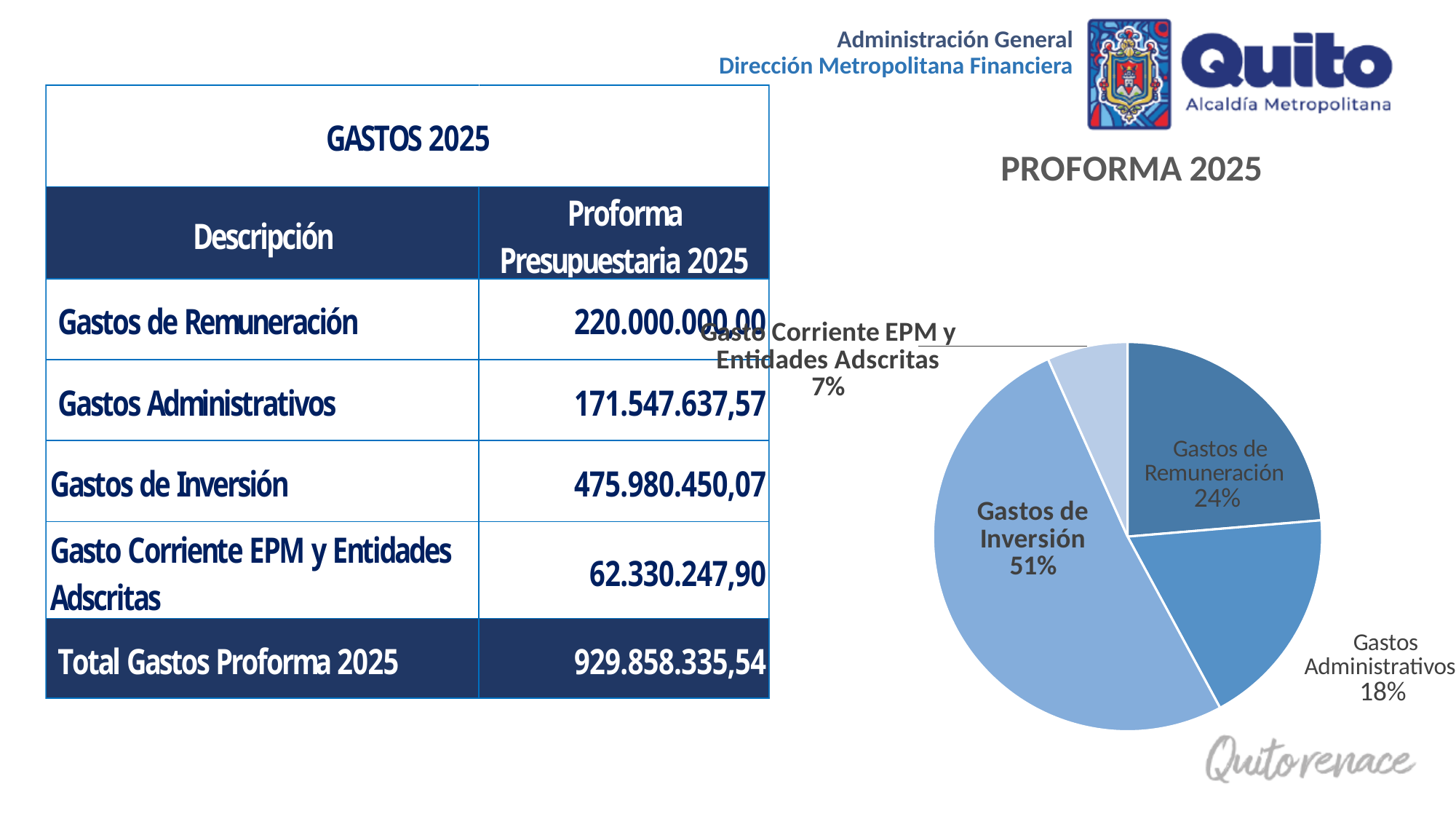
What share of the pie does Gastos de Remuneración represent? 24% What is the title of the pie chart? PROFORMA 2025 Which slice is larger, Gastos de Remuneración or Gastos Administrativos? Gastos de Remuneración What share of the pie does Gasto Corriente EPM y Entidades Adscritas represent? 7% How many slices does the pie chart have? 4 What share of the pie does Gastos Administrativos represent? 18% What is the difference in percentage points between the Gastos de Inversión slice and the Gastos de Remuneración slice? 27 percentage points Which slice of the pie chart is the smallest? Gasto Corriente EPM y Entidades Adscritas What kind of chart is shown on the slide? Pie chart Which slice of the pie chart is the largest? Gastos de Inversión What is the combined share of the Gastos de Remuneración and Gastos Administrativos slices? 42%